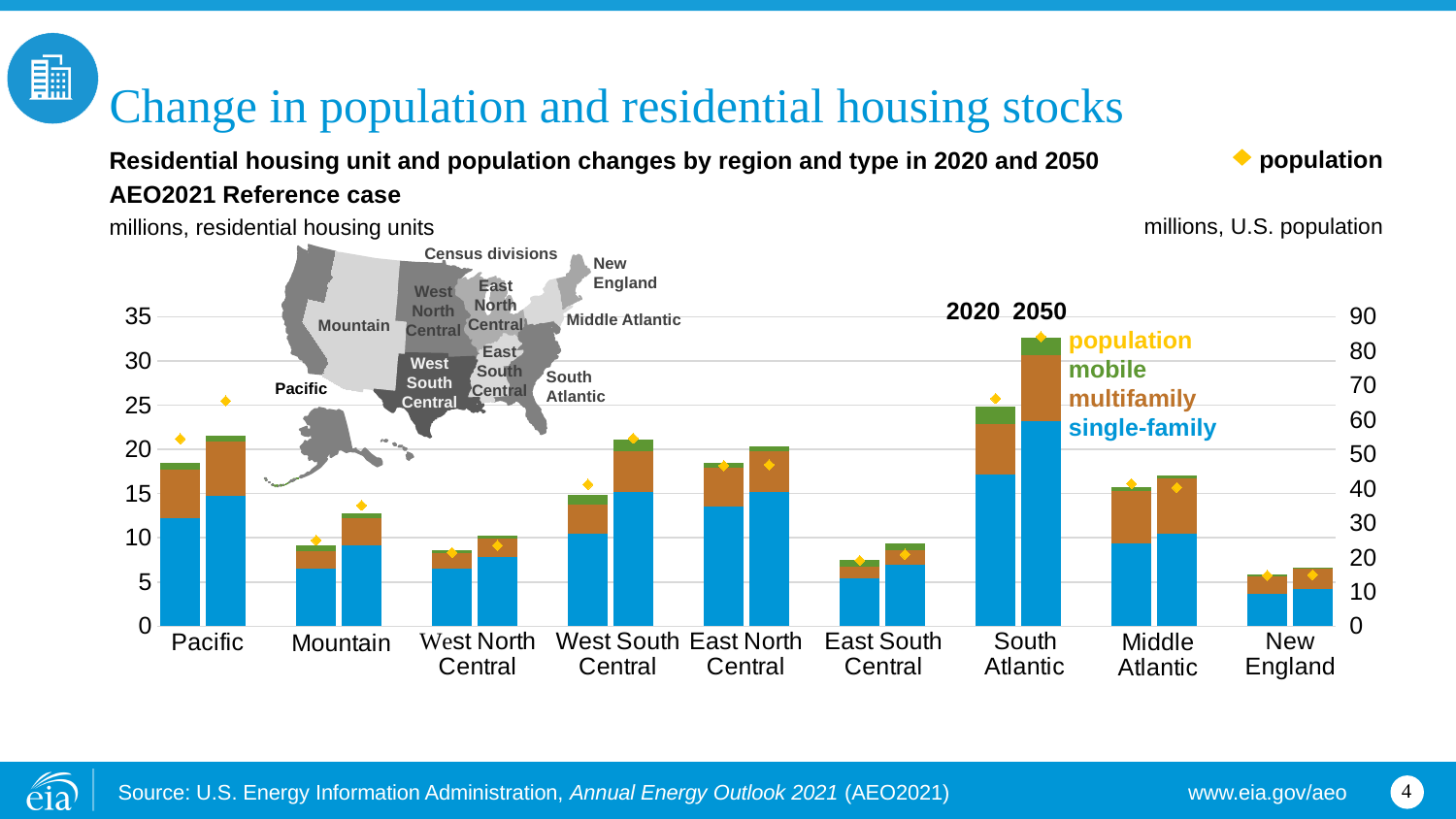
For each region, does the total residential housing units bar rise or fall from 2020 to 2050? rise What unit does the right-hand axis of the chart measure? millions, U.S. population What kind of chart is shown on the slide? stacked bar chart Is the total residential housing units bar for New England in 2020 greater or less than 10 million? less Is the population marker for South Atlantic in 2050 greater or less than 70 million? greater Which region and year has the shortest stacked bar for residential housing units? New England, 2020 How many entries does the chart's legend list? 4 Is the total residential housing units bar for South Atlantic in 2050 greater or less than 30 million? greater Which has the larger total residential housing units bar in 2050: South Atlantic or Pacific? South Atlantic How many regions (census divisions) are shown along the x axis of the chart? 9 Which region and year has the tallest stacked bar for residential housing units? South Atlantic, 2050